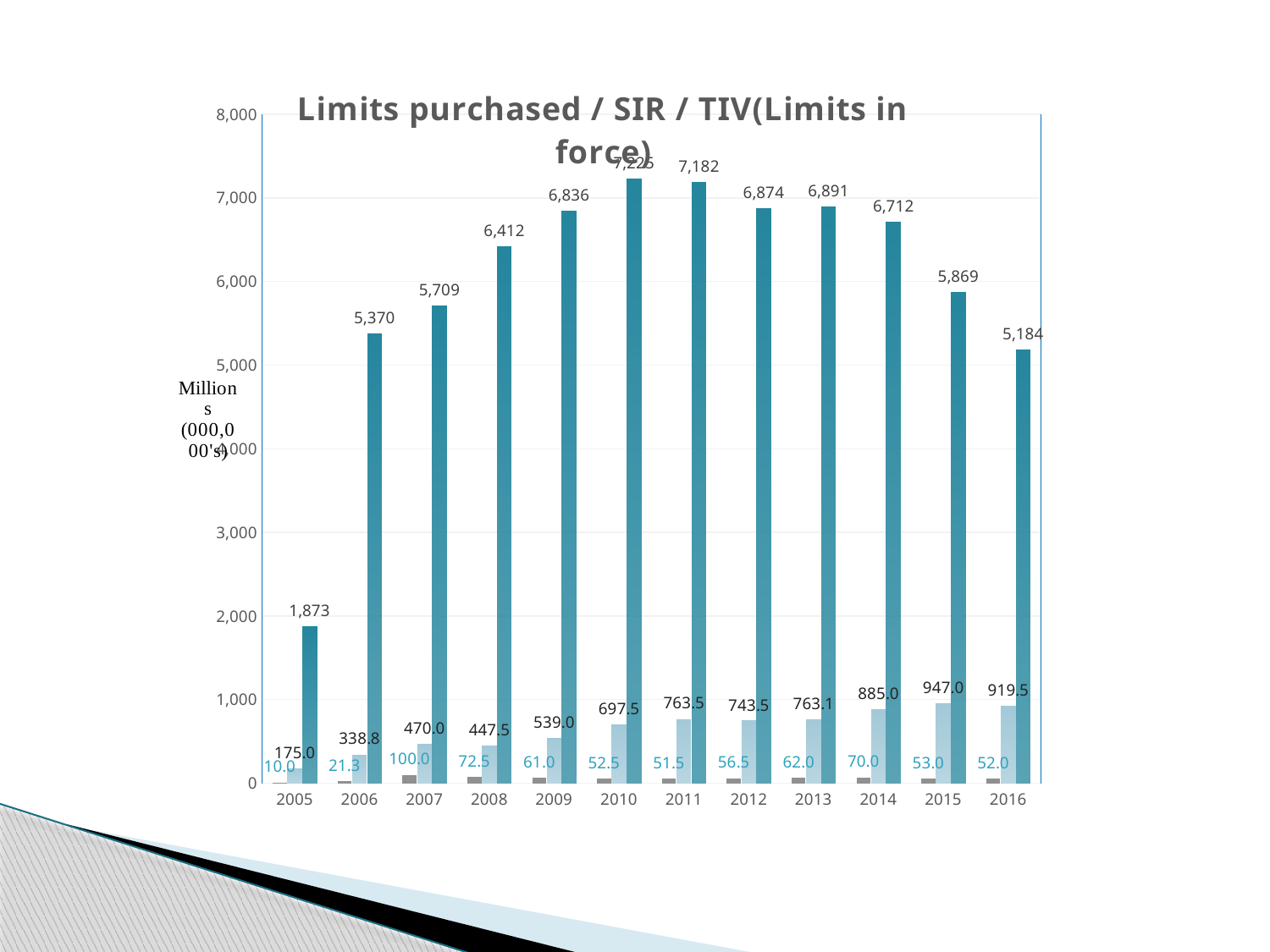
Is the dark teal bar value for 2006 greater or less than 5,000? greater What is the value of the tallest (dark teal) bar for 2008? 6,412 What is the value of the small gray bar for 2007? 100.0 In which year is the tallest (dark teal) bar the lowest? 2005 What is the value of the light blue bar for 2014? 885.0 Which year has the larger dark teal bar value, 2015 or 2016? 2015 How many years are shown on the x axis of the chart? 12 What is the title of the chart? Limits purchased / SIR / TIV(Limits in force) What is the value of the small gray bar for 2006? 21.3 What kind of chart is shown on the slide? bar chart What is the difference between the dark teal bar values for 2011 and 2016? 1,998 In which year is the light blue bar the highest? 2015